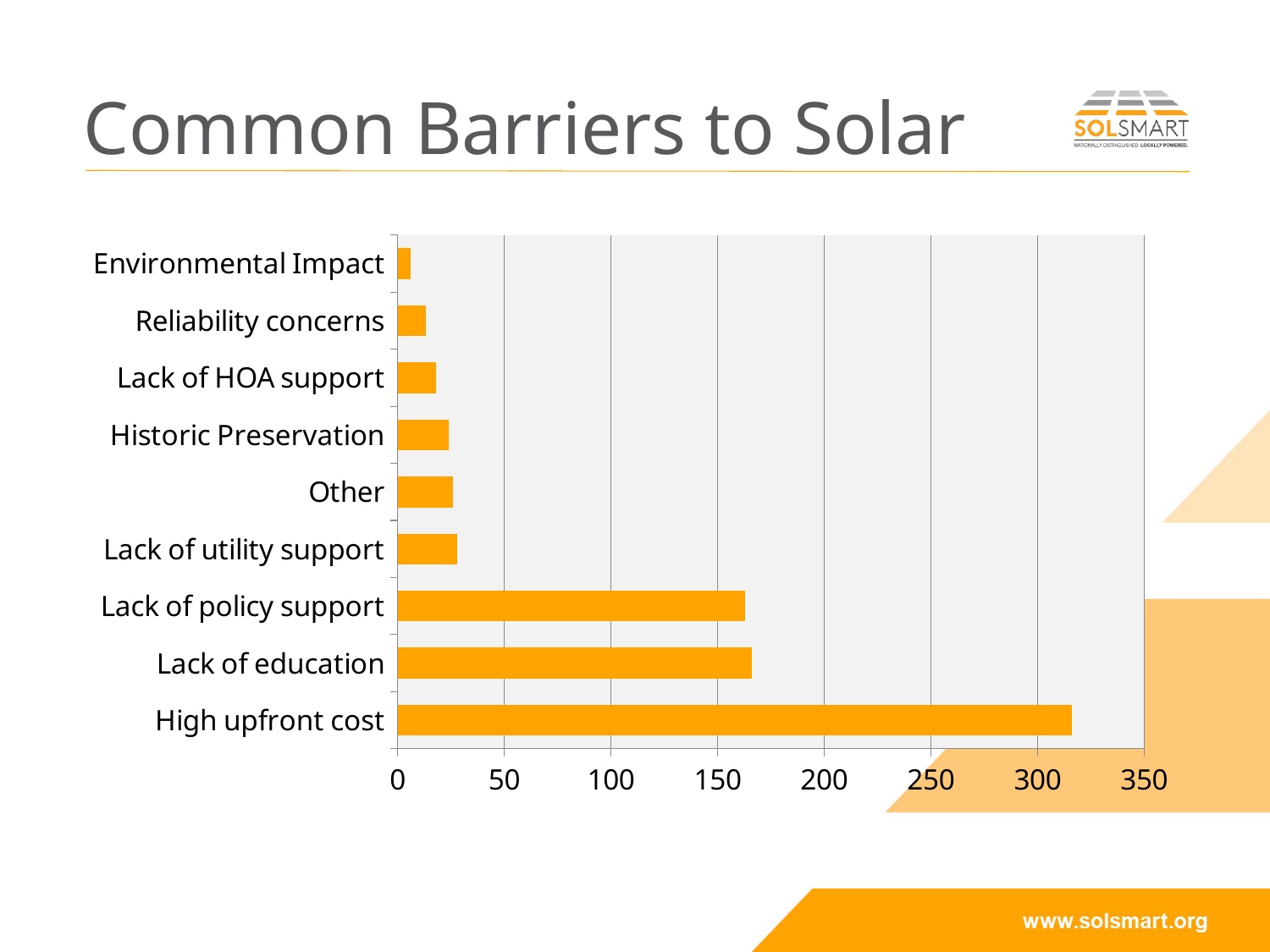
Is the value for Lack of policy support greater or less than 200? less Which is larger, the value for Lack of utility support or the value for Environmental Impact? Lack of utility support Which barrier has the lowest value? Environmental Impact What is the highest value shown on the horizontal axis? 350 Is the value for Lack of utility support greater or less than 50? less What is the title of the slide? Common Barriers to Solar Which is larger, the value for High upfront cost or the value for Lack of education? High upfront cost How many barrier categories are plotted in the chart? 9 Is the value for High upfront cost greater or less than 300? greater Which barrier has the highest value? High upfront cost What kind of chart is shown on the slide? bar chart